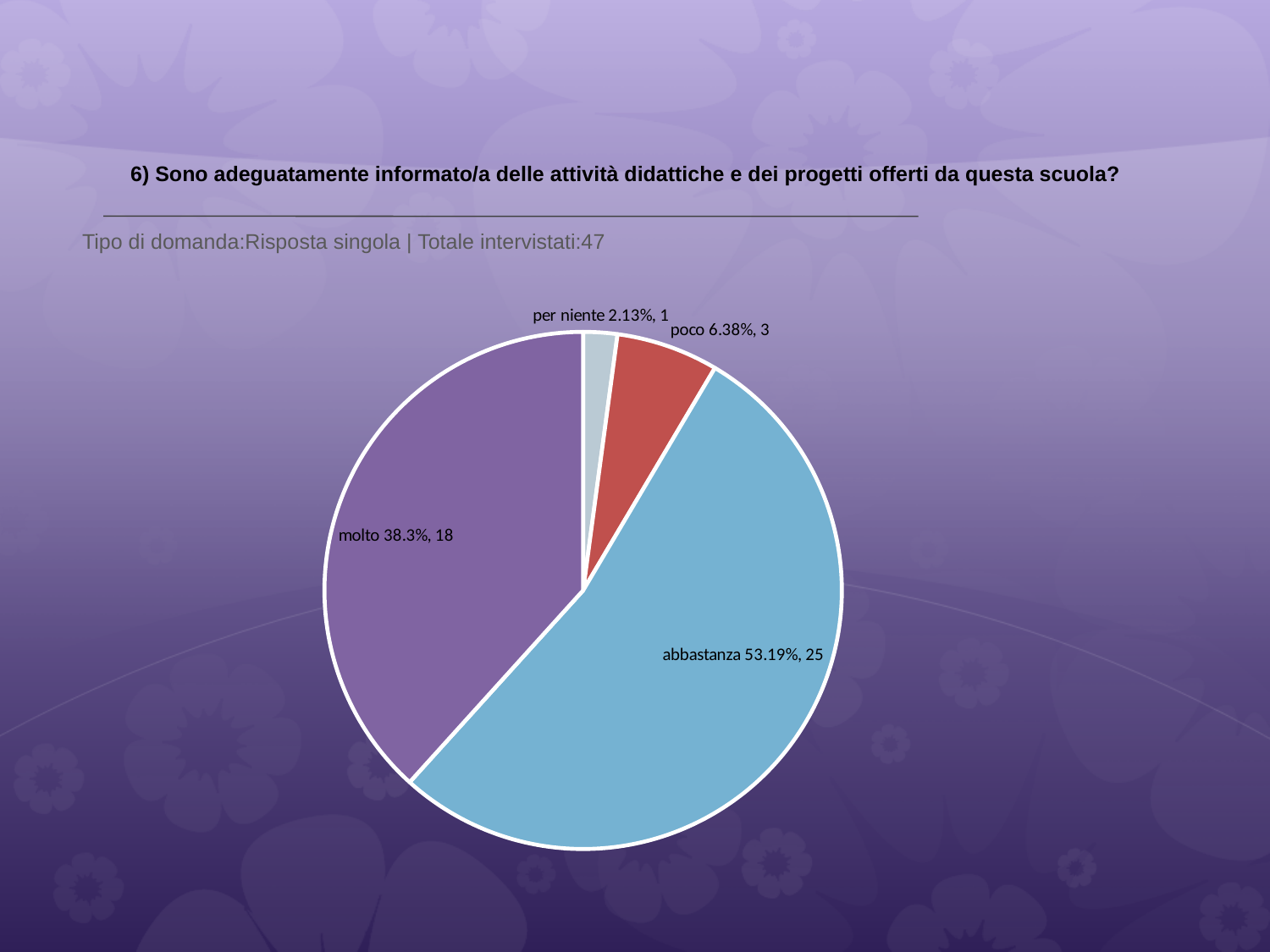
What is the total number of respondents (Totale intervistati) shown on the slide? 47 Which has more respondents, 'poco' or 'per niente'? poco What is the difference in respondent count between 'abbastanza' and 'molto'? 7 How many respondents answered 'molto'? 18 How many slices does the pie chart have? 4 What kind of chart is shown on the slide? pie chart Which category has the smallest slice? per niente How many respondents answered 'poco'? 3 Which category has the largest slice? abbastanza What percentage share does the 'abbastanza' slice have? 53.19% What percentage share does the 'per niente' slice have? 2.13% What colour is the 'molto' slice? purple